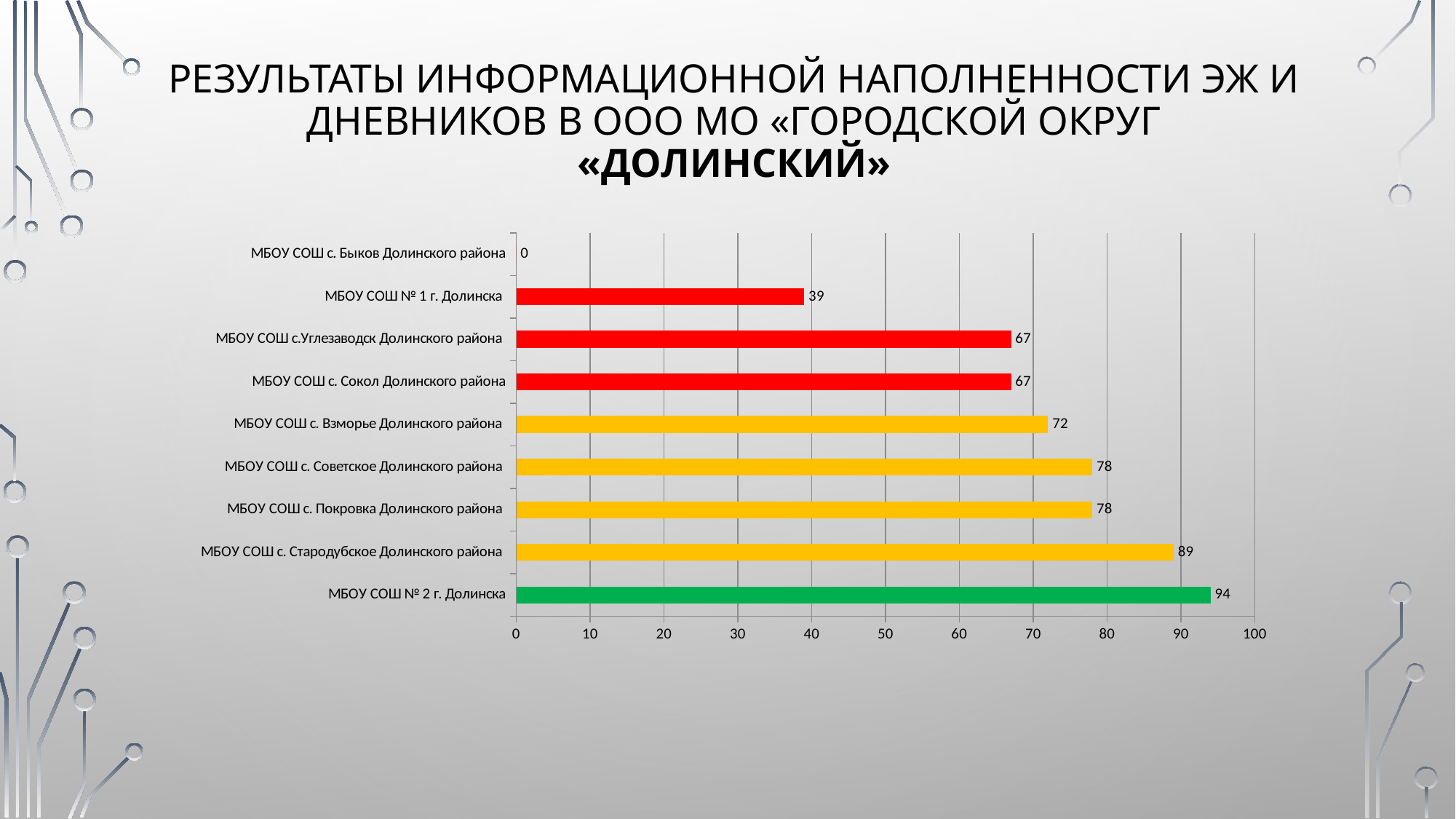
Is the value for МБОУ СОШ с. Покровка Долинского района greater or less than 70? greater What is the value for МБОУ СОШ № 2 г. Долинска? 94 What is the difference between the values for МБОУ СОШ с. Стародубское Долинского района and МБОУ СОШ с. Советское Долинского района? 11 What colour is the bar for МБОУ СОШ № 2 г. Долинска? green How many schools are shown in the chart? 9 Which school has the lowest value? МБОУ СОШ с. Быков Долинского района Which school has the highest value? МБОУ СОШ № 2 г. Долинска Which is larger, the value for МБОУ СОШ с. Сокол Долинского района or МБОУ СОШ с. Взморье Долинского района? МБОУ СОШ с. Взморье Долинского района What kind of chart is shown on the slide? bar chart What is the maximum value shown on the horizontal axis? 100 What is the value for МБОУ СОШ с. Взморье Долинского района? 72 What is the value for МБОУ СОШ № 1 г. Долинска? 39